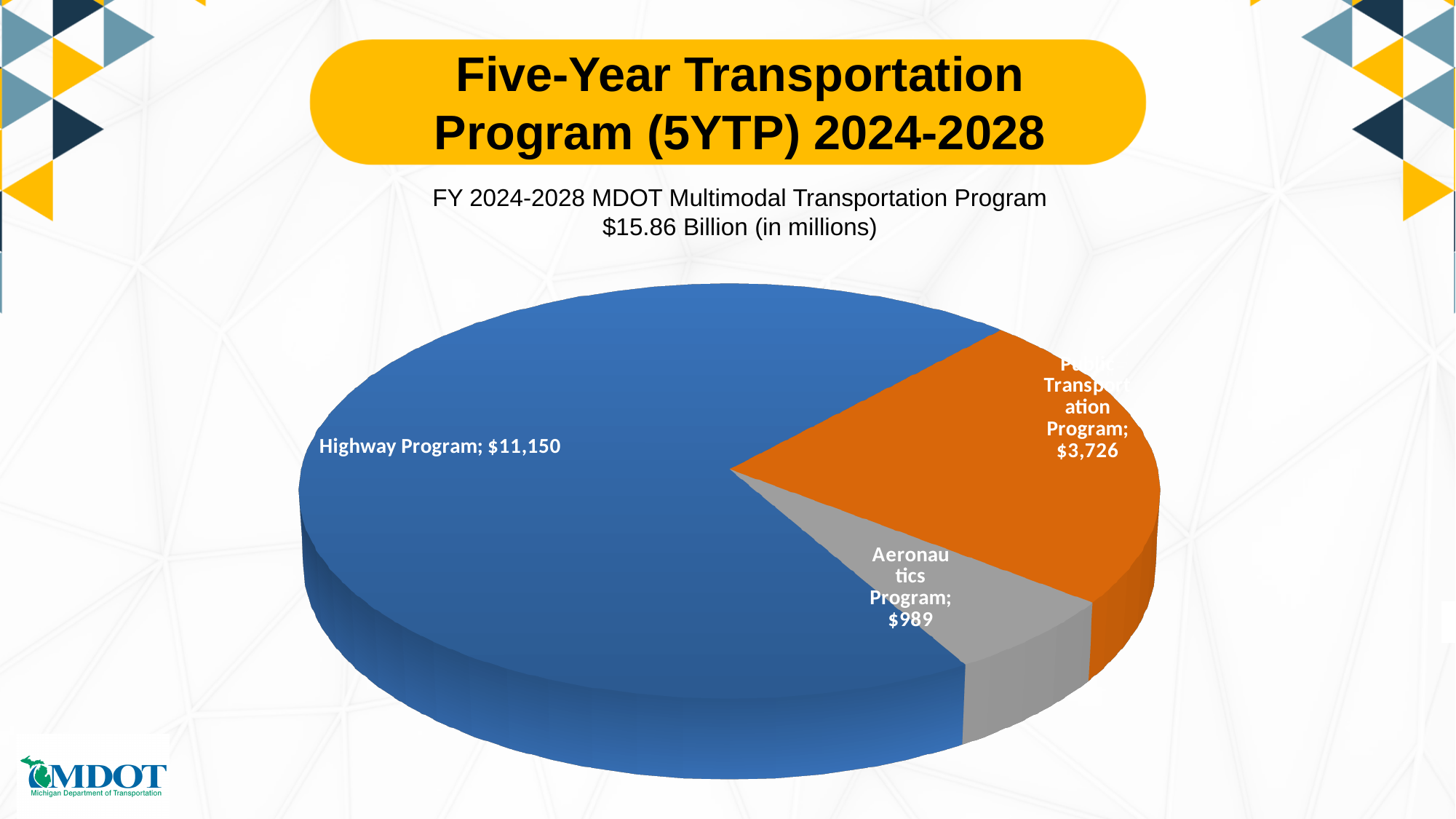
Which program has the largest slice of the pie? Highway Program What is the title of the chart? FY 2024-2028 MDOT Multimodal Transportation Program $15.86 Billion (in millions) What is the value for the Public Transportation Program? $3,726 What is the value for the Aeronautics Program? $989 What is the value for the Highway Program? $11,150 Which is larger, the Public Transportation Program or the Aeronautics Program? Public Transportation Program What kind of chart is shown on the slide? Pie chart What is the difference between the Public Transportation Program and the Aeronautics Program values? $2,737 How many slices does the pie chart have? 3 What is the difference between the Highway Program and the Public Transportation Program values? $7,424 Which program has the smallest slice of the pie? Aeronautics Program